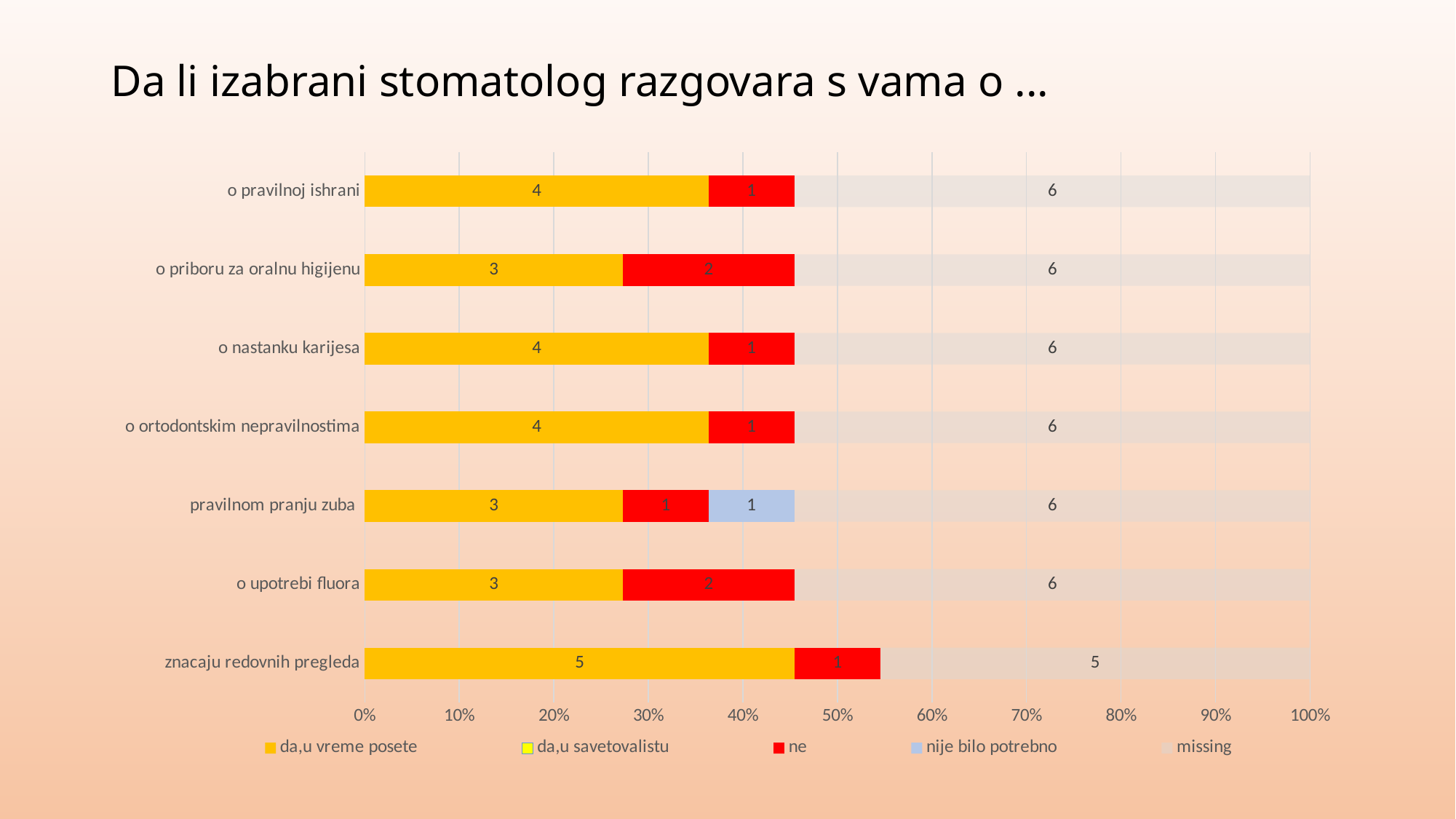
How many series does the legend list? 5 What kind of chart is shown on the slide? Stacked bar chart What is the difference between "da,u vreme posete" and "ne" for "o upotrebi fluora"? 1 Which has the larger "da,u vreme posete" value: "o pravilnoj ishrani" or "o upotrebi fluora"? o pravilnoj ishrani What is the value of "nije bilo potrebno" for "pravilnom pranju zuba"? 1 How many categories are shown on the chart? 7 What is the value of "ne" for "o priboru za oralnu higijenu"? 2 Which category has the highest value for "da,u vreme posete"? znacaju redovnih pregleda What is the title of the chart? Da li izabrani stomatolog razgovara s vama o … What is the total of the stacked bar for "pravilnom pranju zuba"? 11 What is the value of "da,u vreme posete" for "znacaju redovnih pregleda"? 5 What is the value of "missing" for "znacaju redovnih pregleda"? 5